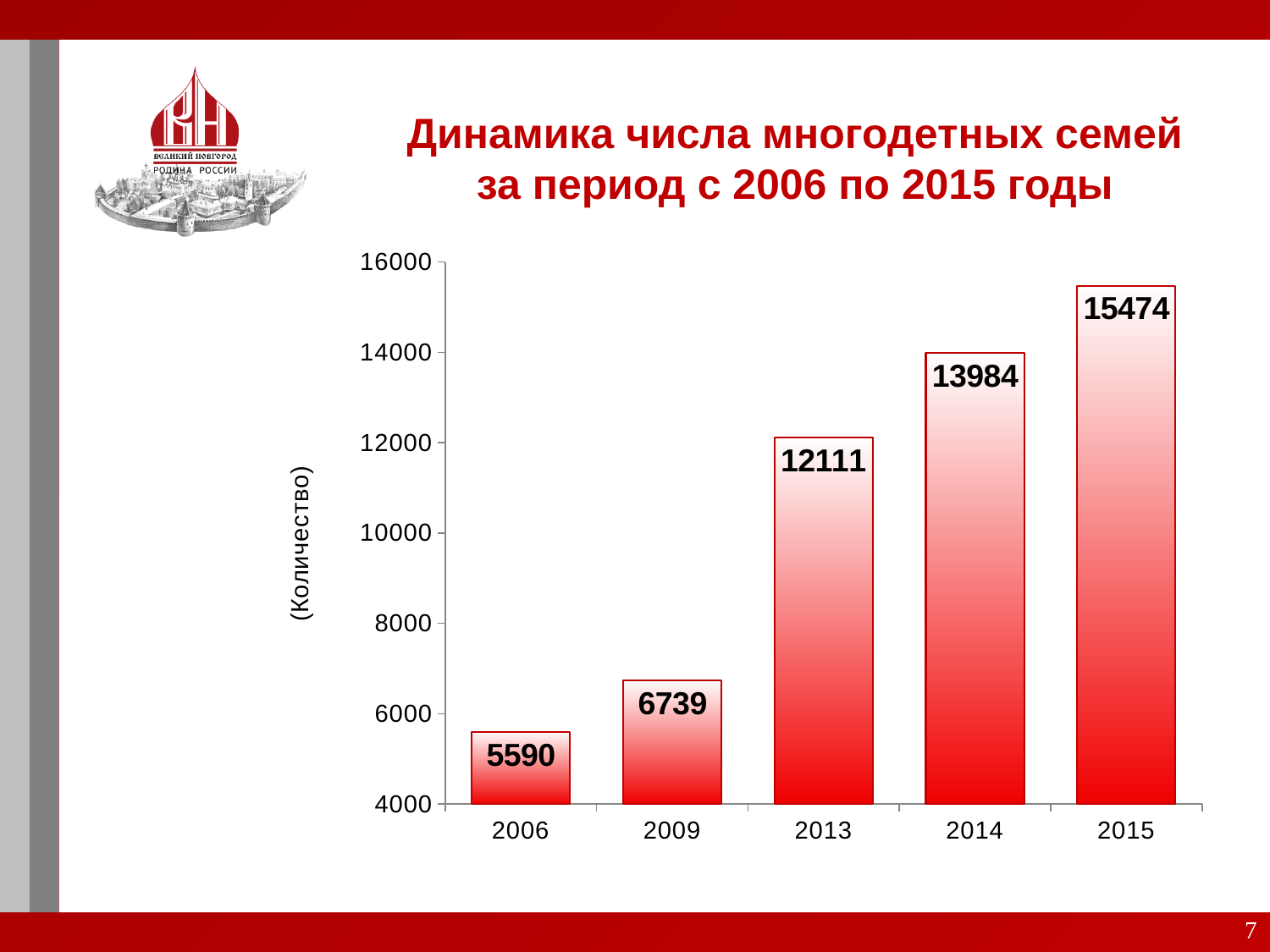
Do the values rise or fall from 2006 to 2015? rise Which year has the highest value? 2015 How many years are shown on the x axis? 5 What is the value for 2015? 15474 Which year has the lowest value? 2006 What is the value for 2006? 5590 Which is larger, the value for 2013 or the value for 2009? 2013 What is the difference between the values for 2015 and 2014? 1490 What is the difference between the values for 2009 and 2006? 1149 Is the value for 2014 greater or less than 12000? greater What kind of chart is shown on the slide? bar chart What is the value for 2013? 12111